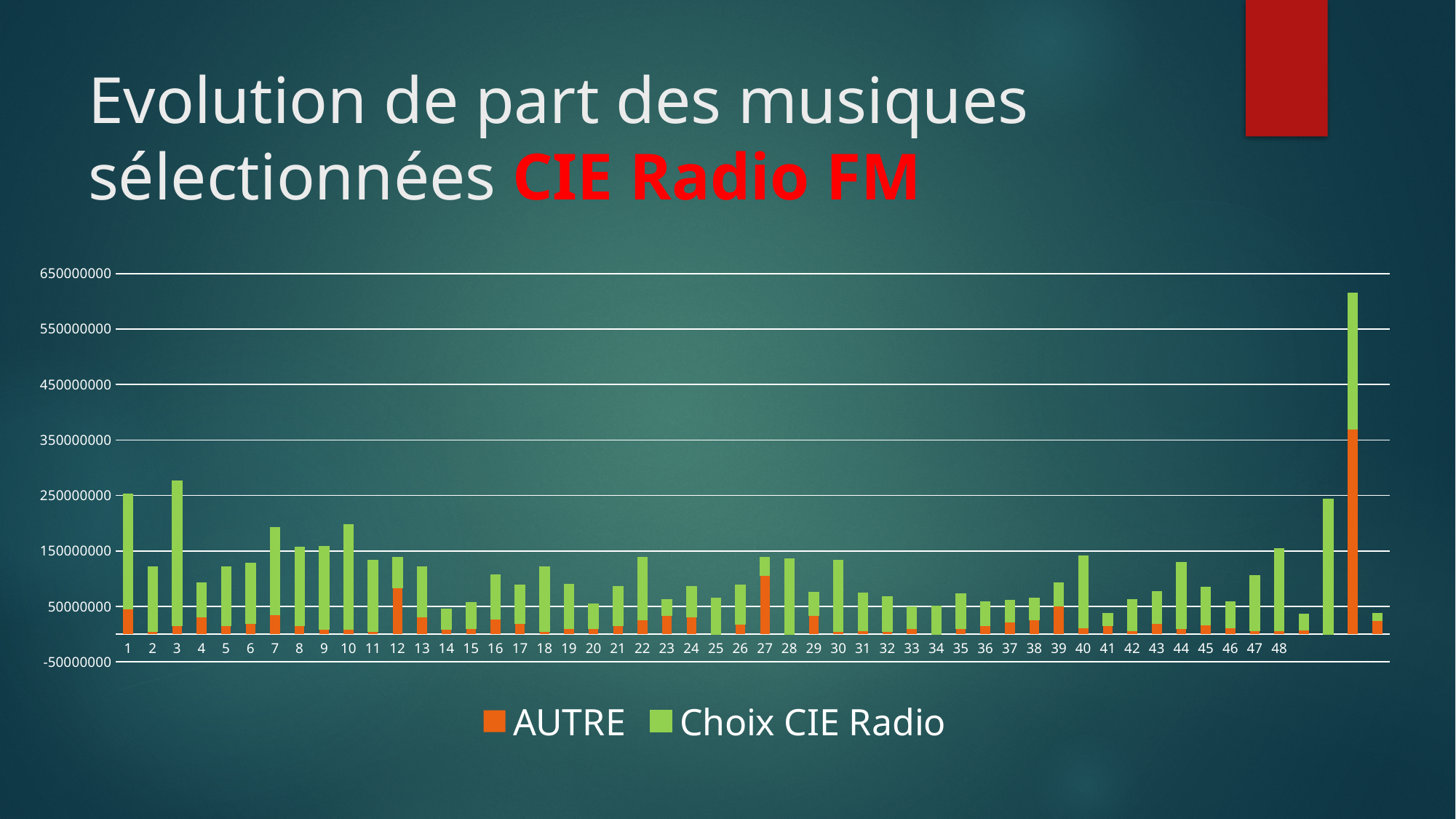
Which series is shown in green in the legend? Choix CIE Radio How many series does the legend list? 2 Is the AUTRE value for category 27 greater or less than 50000000? greater Which has the larger total bar, category 2 or category 3? 3 What kind of chart is shown on the slide? Stacked bar chart Which has the larger AUTRE value, category 12 or category 27? 27 Is the total value for category 20 greater or less than 150000000? less Among the labelled categories 1 to 48, which category has the tallest bar? 3 Is the total value for category 3 greater or less than 250000000? greater Which series is shown in orange in the legend? AUTRE